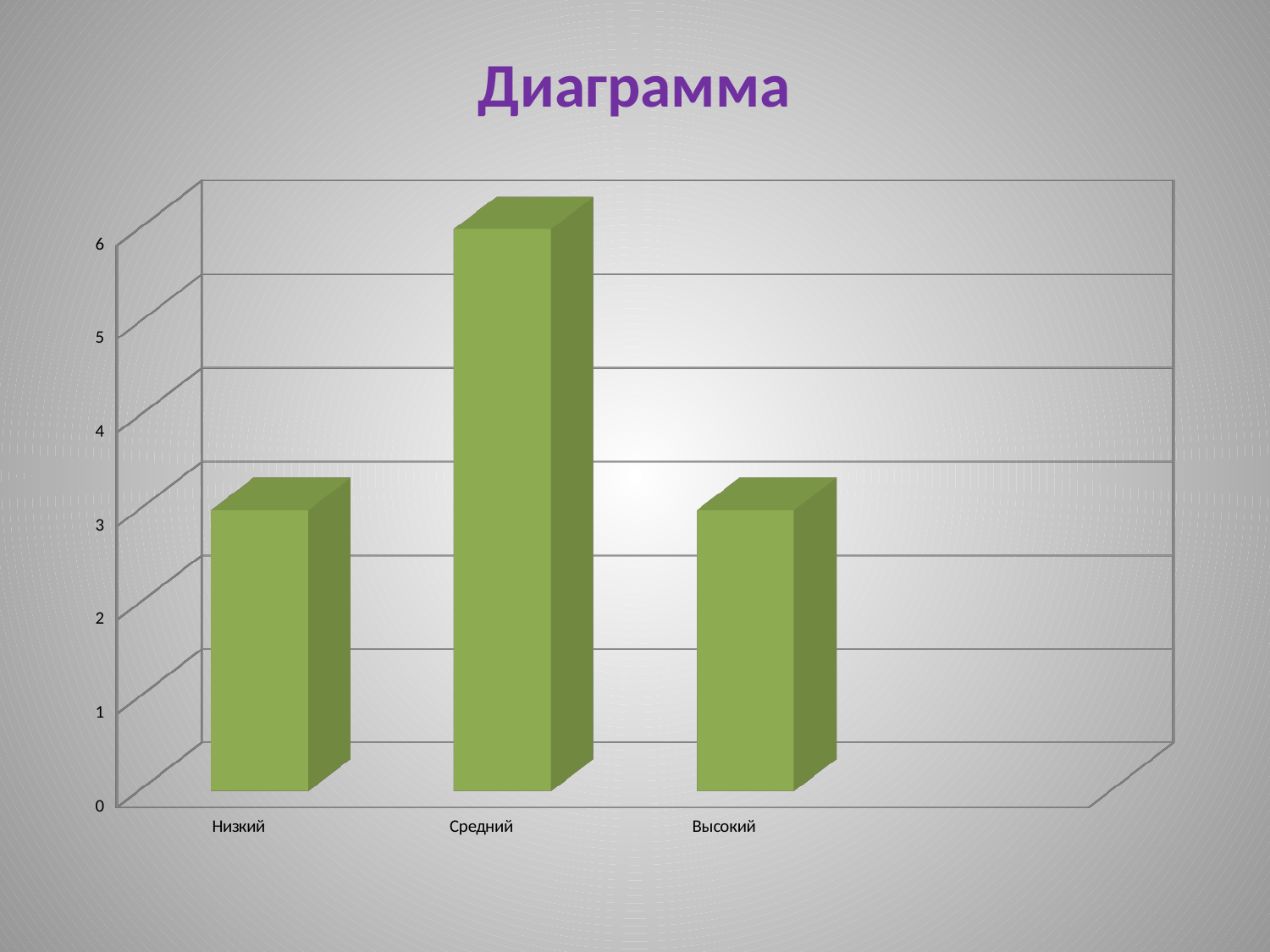
What kind of chart is shown on the slide? bar chart Is the value for Высокий greater or less than 5? less What colour are the bars in the chart? green Which is larger, the value for Средний or the value for Низкий? Средний What is the highest value labelled on the vertical axis? 6 How many categories are shown on the x axis? 3 Is the value for Средний greater or less than 5? greater Is the value for Высокий greater or less than 2? greater Which is larger, the value for Средний or the value for Высокий? Средний Which category has the highest bar? Средний What is the title of the chart? Диаграмма